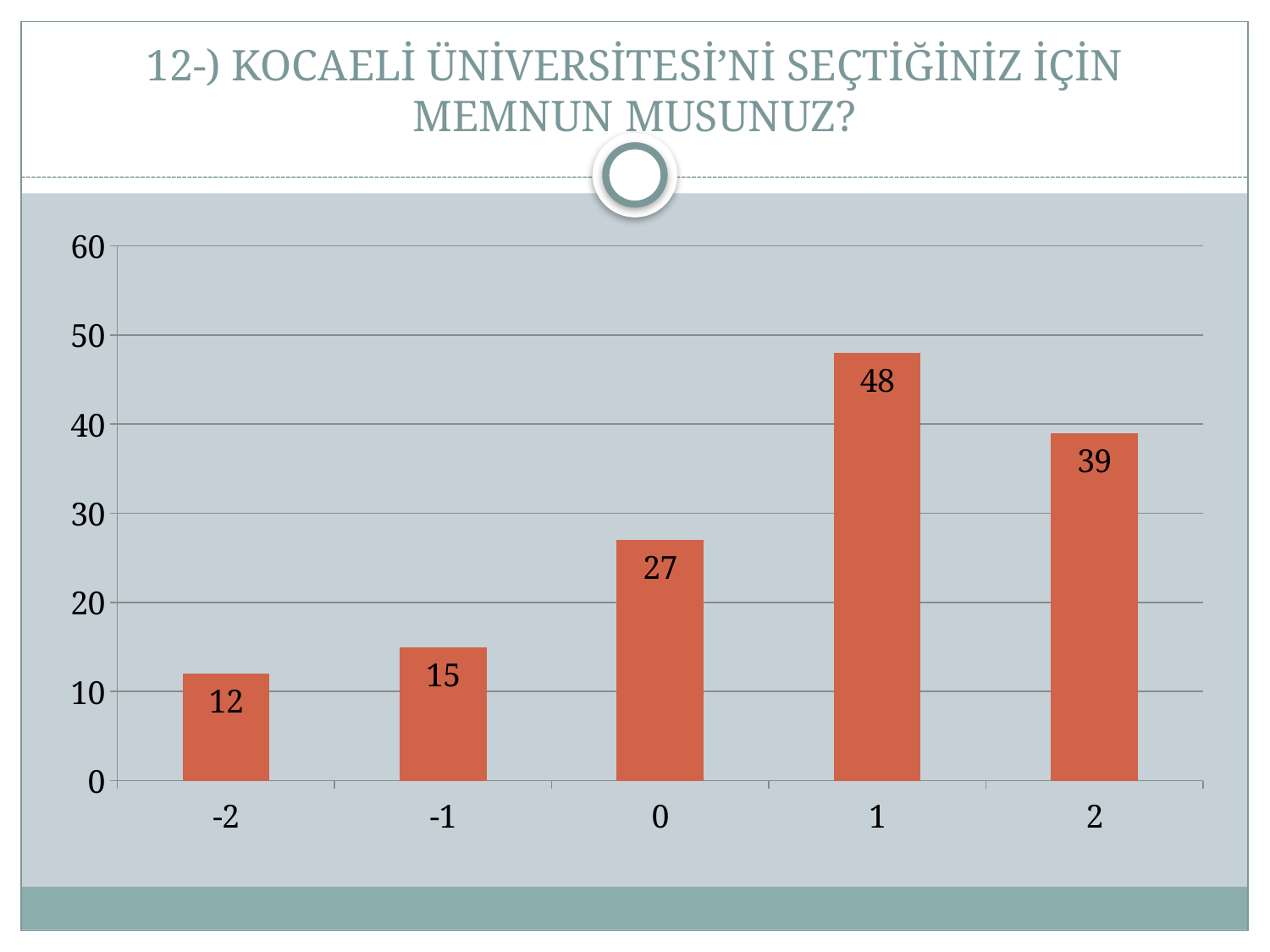
Which category has the highest value? 1 Which is larger, the value for category 2 or the value for category 0? 2 What is the difference between the values for category 0 and category -1? 12 How many categories are shown on the x axis? 5 What is the difference between the values for category 1 and category 2? 9 What kind of chart is shown on the slide? bar chart What is the value for category 0? 27 What is the value for category -2? 12 Is the value for category 2 greater or less than 30? greater What is the value for category 1? 48 Which category has the lowest value? -2 What is the title of the slide? 12-) KOCAELİ ÜNİVERSİTESİ'Nİ SEÇTİĞİNİZ İÇİN MEMNUN MUSUNUZ?